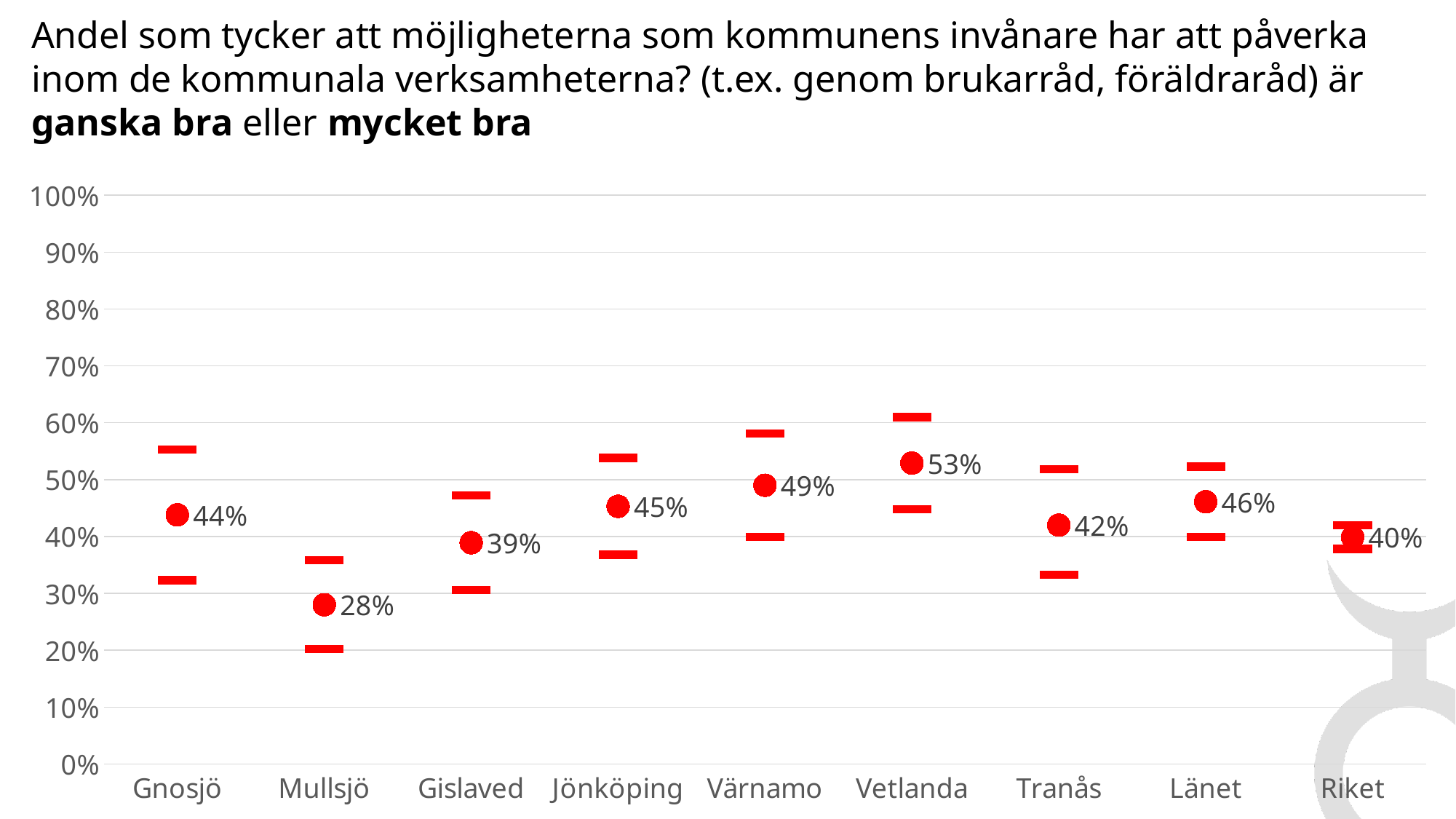
What is the difference between the values for Länet and Riket? 6% What is the value for Riket? 40% Which category has the highest value? Vetlanda Is the value for Gislaved greater or less than 40%? less What colour are the plotted points and error bars? Red What is the value for Vetlanda? 53% How many categories are shown on the x axis? 9 What is the difference between the values for Vetlanda and Mullsjö? 25% What kind of chart is this? Dot plot with error bars What is the value for Mullsjö? 28% Which category has the lowest value? Mullsjö Which is larger, the value for Värnamo or the value for Tranås? Värnamo